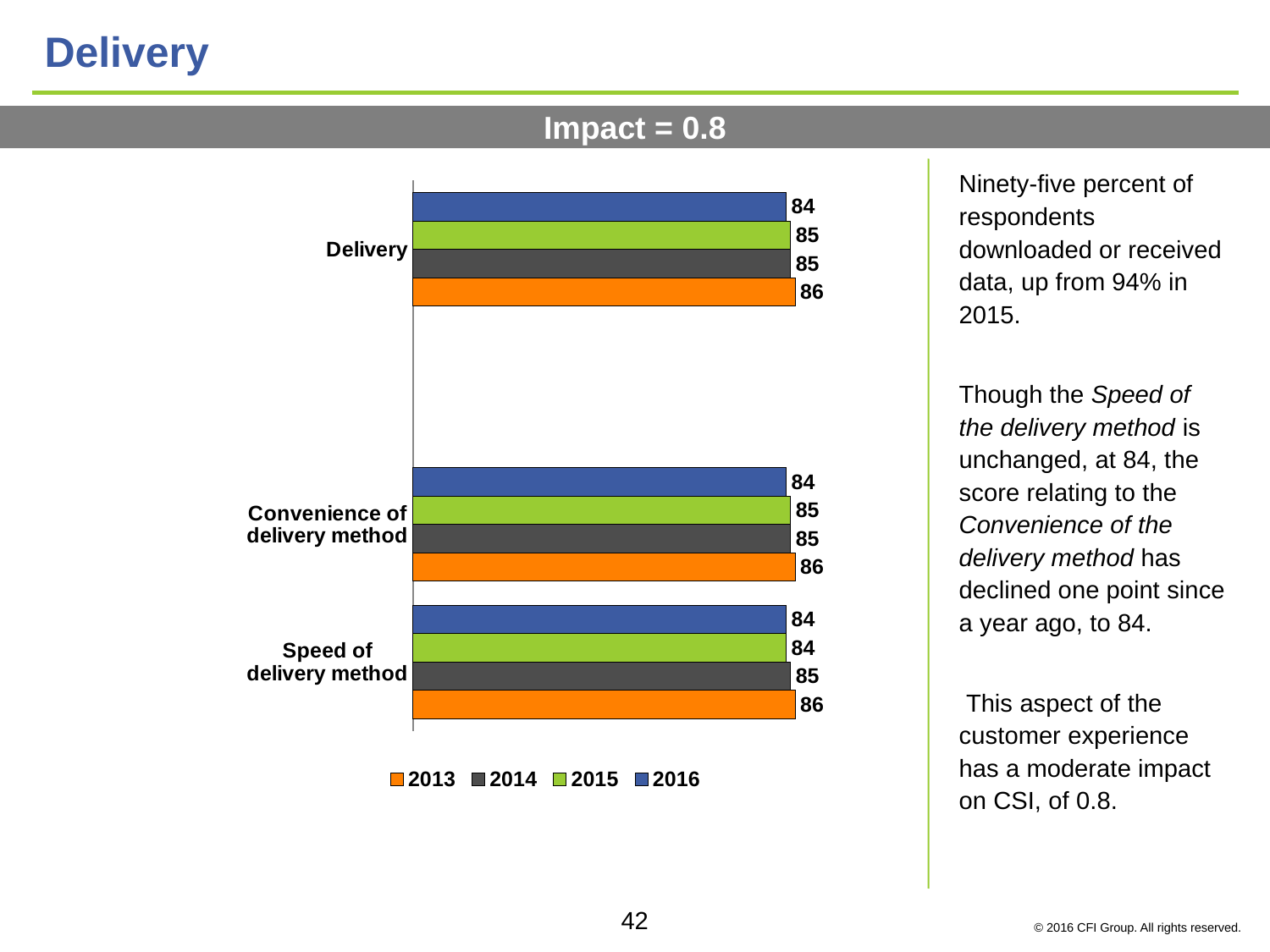
What kind of chart is shown on the slide? Bar chart What is the difference between the 2013 and 2016 values for Delivery? 2 What is the 2013 value for Speed of delivery method? 86 What is the 2015 value for Convenience of delivery method? 85 Which colour represents 2015 in the legend? Green How many categories are shown on the chart? 3 Which is larger for Convenience of delivery method, the 2013 value or the 2016 value? 2013 Which year has the highest value for Speed of delivery method? 2013 What is the 2016 value for Delivery? 84 What is the 2014 value for Speed of delivery method? 85 How many series does the legend list? 4 What is the difference between the 2014 and 2015 values for Speed of delivery method? 1